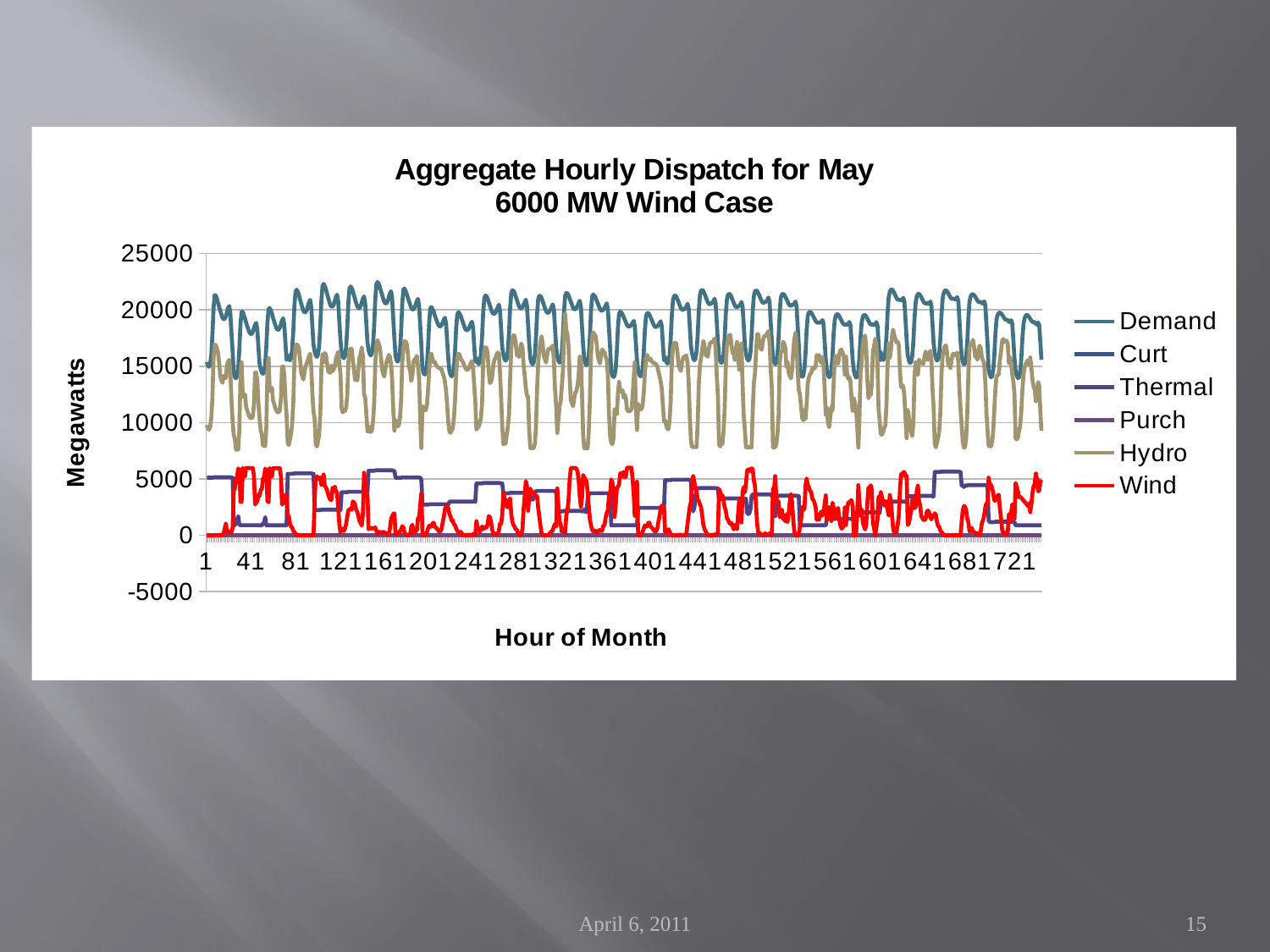
How many series does the legend list? 6 Is the highest Demand value greater or less than 20000? greater What kind of chart is shown on the slide? line chart Is the peak value of the Wind series greater or less than 10000? less What is the title of the chart? Aggregate Hourly Dispatch for May 6000 MW Wind Case Which series is higher, Demand or Hydro? Demand Which series is higher, Hydro or Thermal? Hydro Is the Demand series greater or less than 10000 throughout the month? greater What is the lowest value shown on the vertical axis? -5000 What is the label of the vertical axis? Megawatts Which series has the highest values throughout the chart? Demand